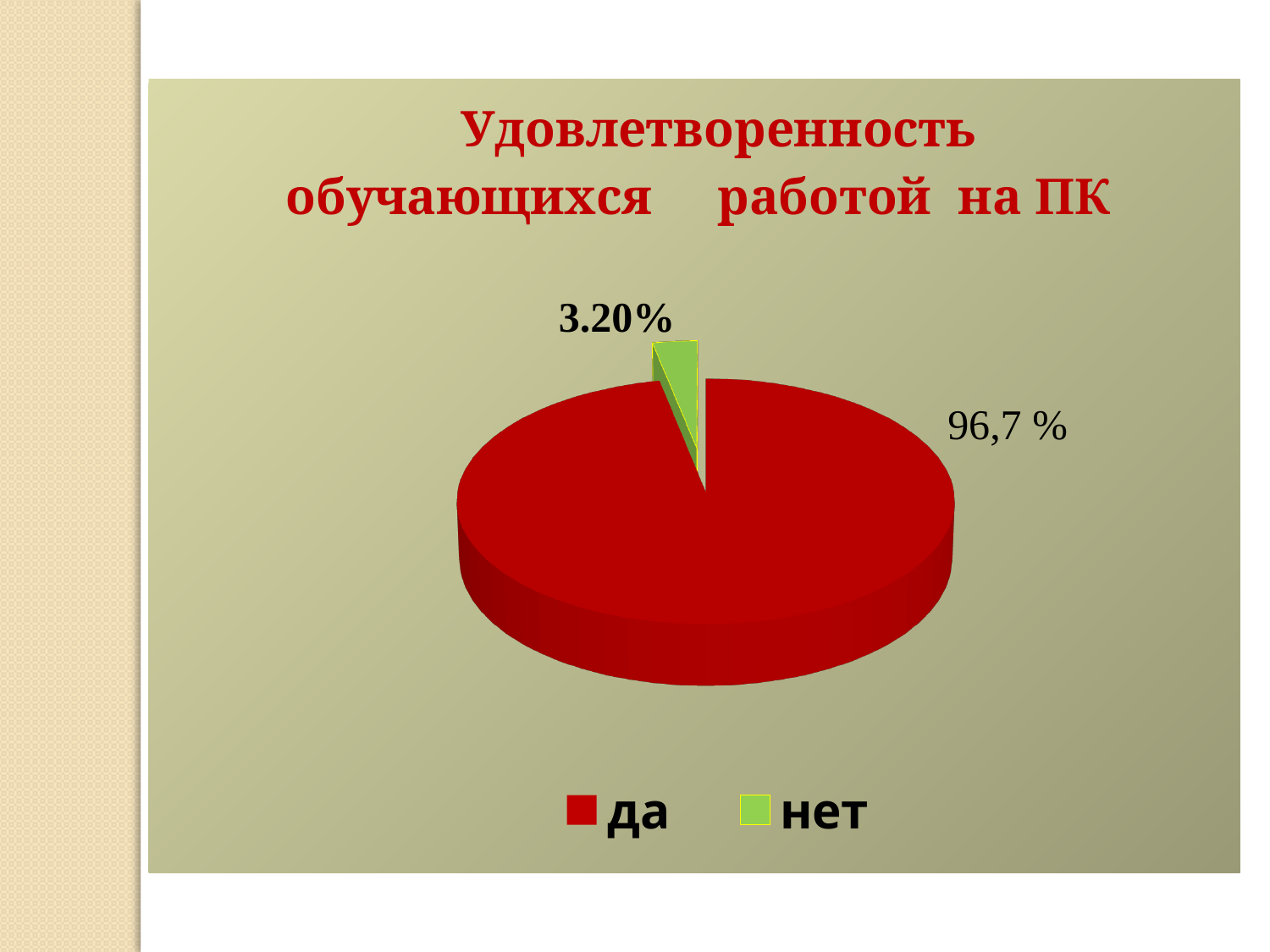
What colour is the "нет" slice? green How many entries does the legend list? 2 What is the value shown for the "нет" slice? 3.20% What type of chart is shown on the slide? pie chart How many slices does the pie chart have? 2 Which slice is the largest? да What is the value shown for the "да" slice? 96,7 % What is the title of the chart? Удовлетворенность обучающихся работой на ПК Which slice is the smallest? нет Which is larger, the "да" slice or the "нет" slice? да